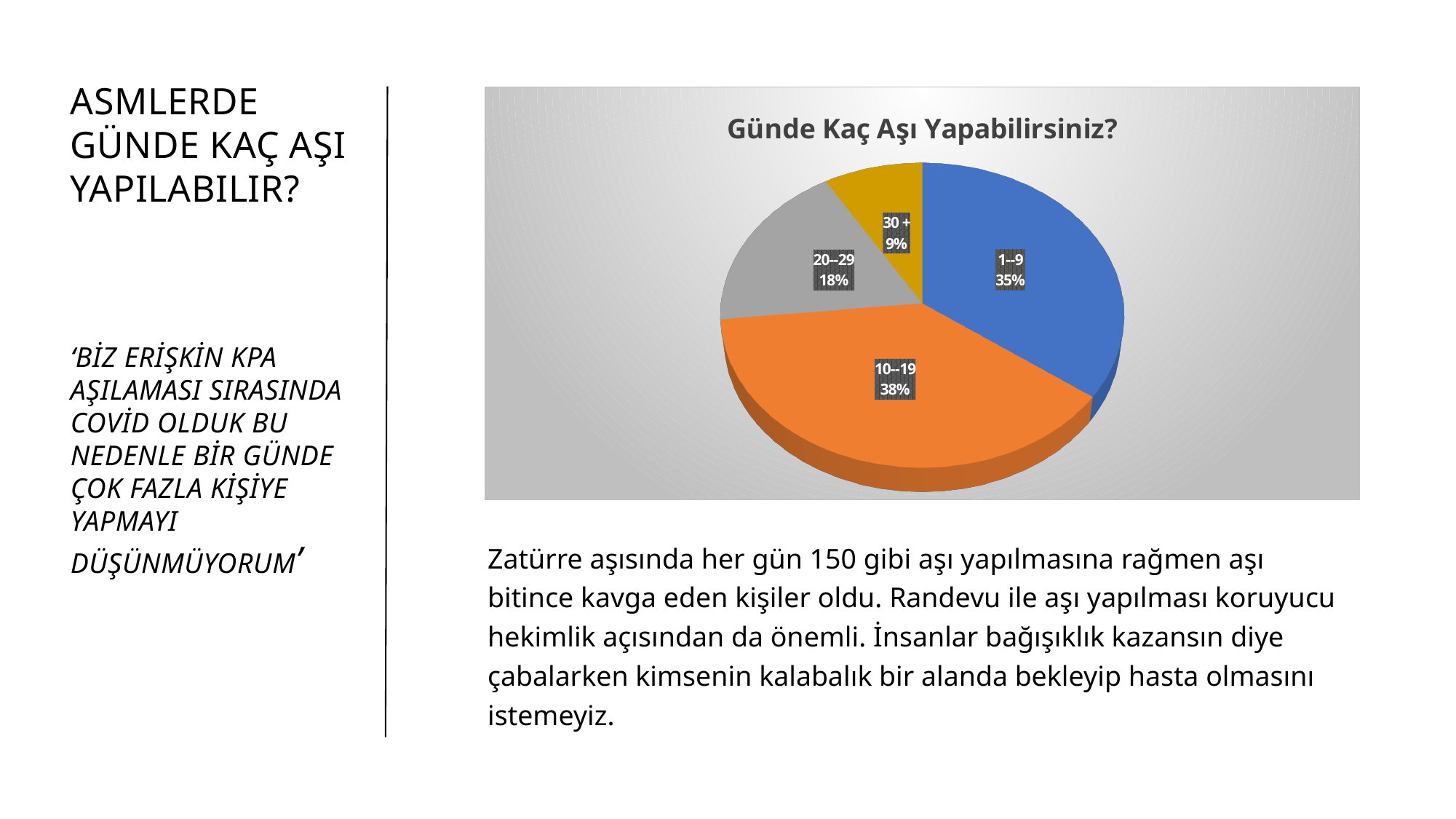
What share of the pie does the 30 + slice represent? 9% What kind of chart is shown on the slide? pie chart Which category has the largest share of the pie? 10--19 What colour is the 10--19 slice? orange Which slice is larger, 20--29 or 30 +? 20--29 How many slices does the pie chart have? 4 What is the difference in percentage points between the 10--19 slice and the 1--9 slice? 3 What share of the pie does the 10--19 slice represent? 38% Which category has the smallest share of the pie? 30 + What share of the pie does the 1--9 slice represent? 35% What is the title of the chart? Günde Kaç Aşı Yapabilirsiniz?